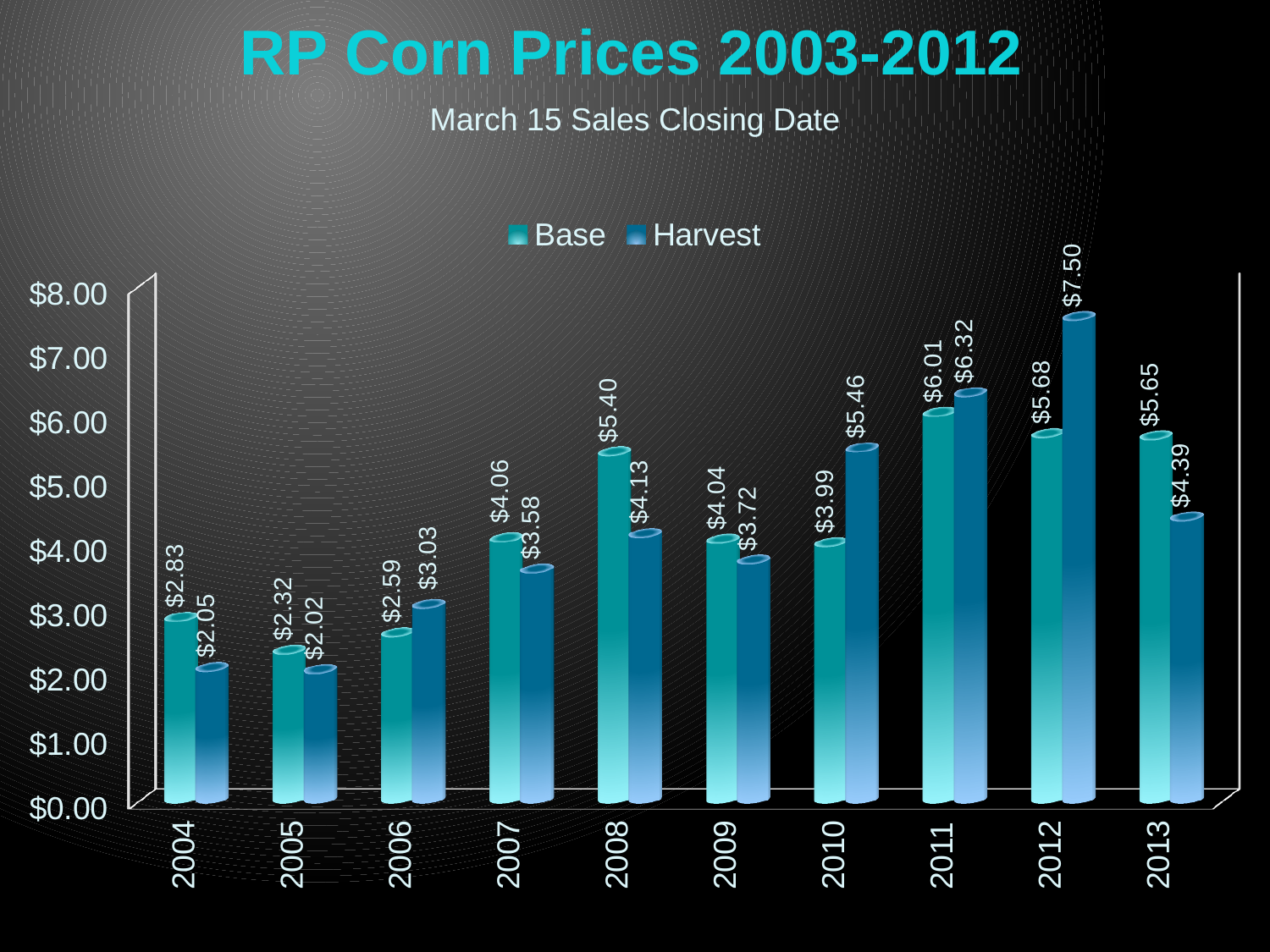
How many years are shown on the x axis? 10 What kind of chart is shown on the slide? Bar chart Which year has the highest Harvest price? 2012 What is the Harvest price for 2013? $4.39 Which year has the highest Base price? 2011 In 2010, which is larger, the Base price or the Harvest price? Harvest What is the Base price for 2008? $5.40 How many series does the legend list? 2 What is the Harvest price for 2012? $7.50 What is the difference between the Harvest and Base prices in 2012? $1.82 What is the difference between the Harvest and Base prices in 2011? $0.31 Which year has the lowest Base price? 2005